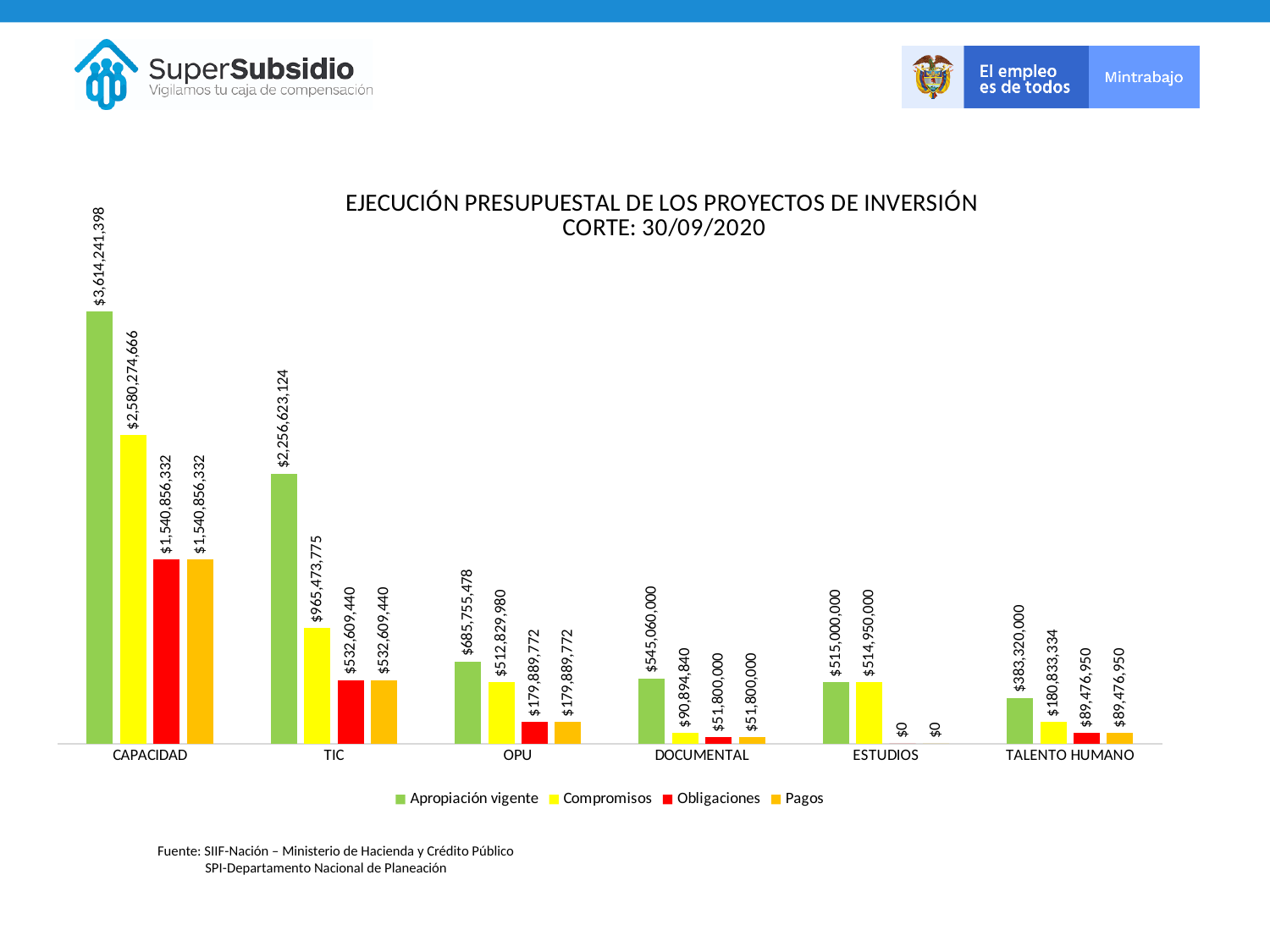
What is the cut-off date (corte) given in the chart title? 30/09/2020 Which category has the lowest Compromisos value? DOCUMENTAL What is the difference between Apropiación vigente and Compromisos for CAPACIDAD? $1,033,966,732 What is the Apropiación vigente value for CAPACIDAD? $3,614,241,398 Which is larger: the Apropiación vigente for DOCUMENTAL or for ESTUDIOS? DOCUMENTAL What type of chart is shown on the slide? Bar chart Which category has the highest Apropiación vigente? CAPACIDAD What is the Obligaciones value for ESTUDIOS? $0 How many categories are shown on the x axis? 6 How many series does the legend list? 4 What is the Pagos value for OPU? $179,889,772 What is the Compromisos value for TIC? $965,473,775